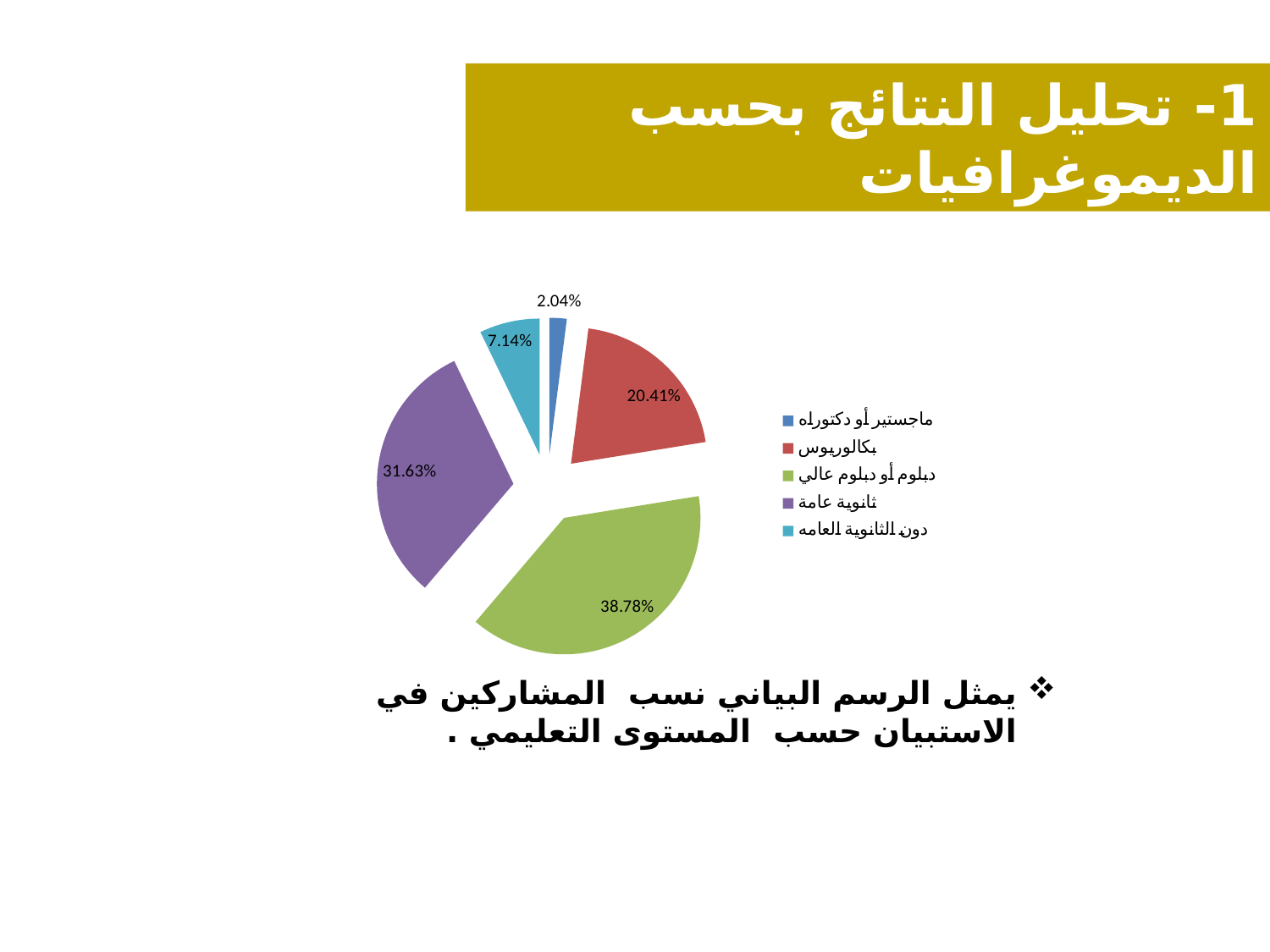
How many slices does the pie chart have? 5 Which is larger, the share for بكالوريوس or the share for دون الثانوية العامة? بكالوريوس Which category has the smallest share of the pie? ماجستير أو دكتوراه What type of chart is shown on the slide? pie chart What percentage is shown for ثانوية عامة? 31.63% What colour is the slice for ثانوية عامة? purple What percentage is shown for بكالوريوس? 20.41% How many entries does the legend list? 5 What percentage is shown for دون الثانوية العامة? 7.14% Which category has the largest share of the pie? دبلوم أو دبلوم عالي What percentage is shown for ماجستير أو دكتوراه? 2.04% What is the difference in percentage points between دبلوم أو دبلوم عالي and ثانوية عامة? 7.15